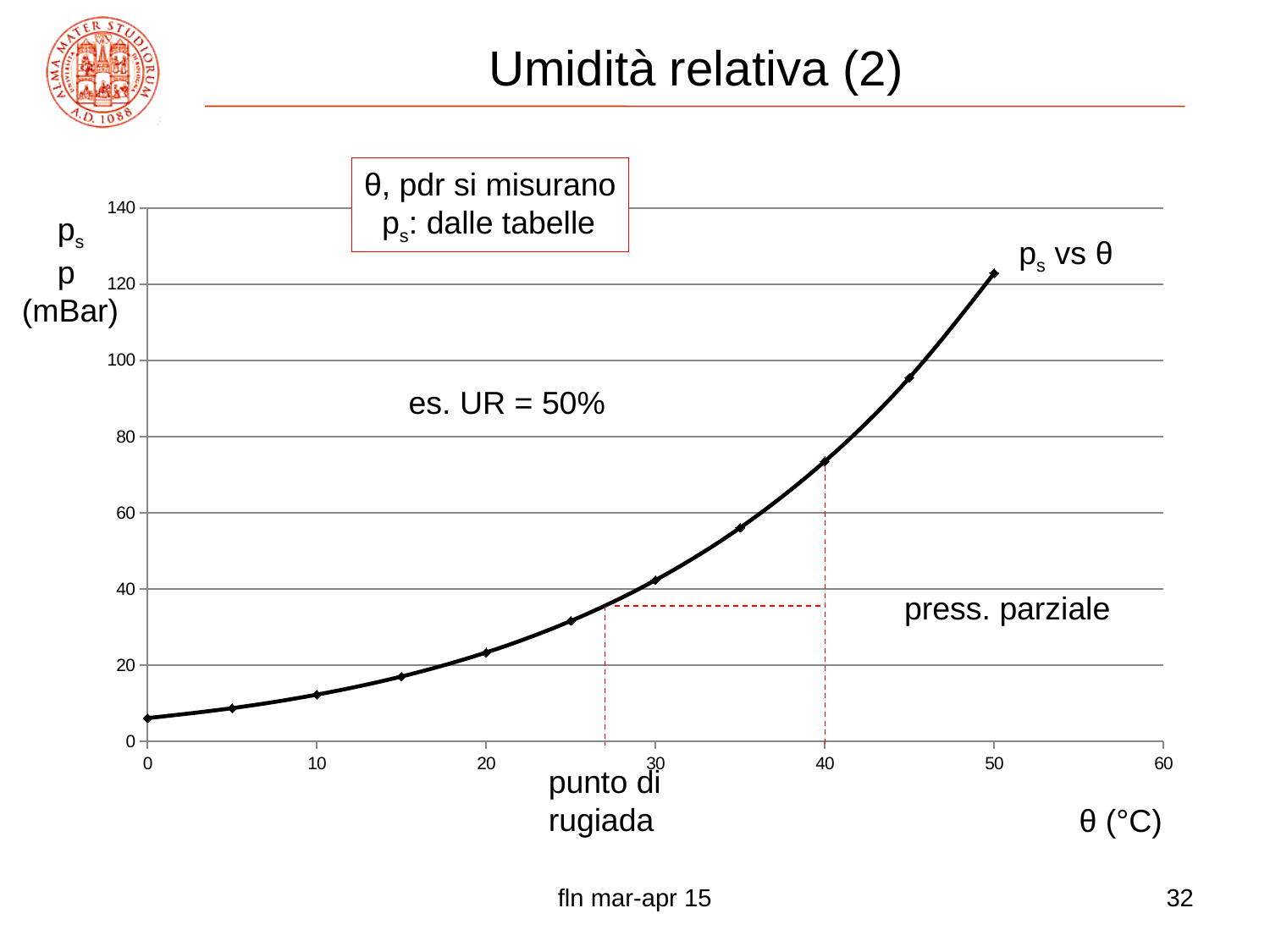
What label is given to the plotted curve on the chart? ps vs θ What kind of chart is shown on the slide? line chart How many data points are marked on the curve? 11 At which temperature θ is the plotted pressure highest? 50 What unit is shown on the x axis label? °C Does the plotted curve rise or fall as θ increases along the x axis? rises Is the value at θ = 0 greater or less than 20? less At which temperature θ is the plotted pressure lowest? 0 Is the value at θ = 50 greater or less than 100? greater Is the value at θ = 40 greater or less than 80? less Which is larger, the value at θ = 30 or the value at θ = 45? θ = 45